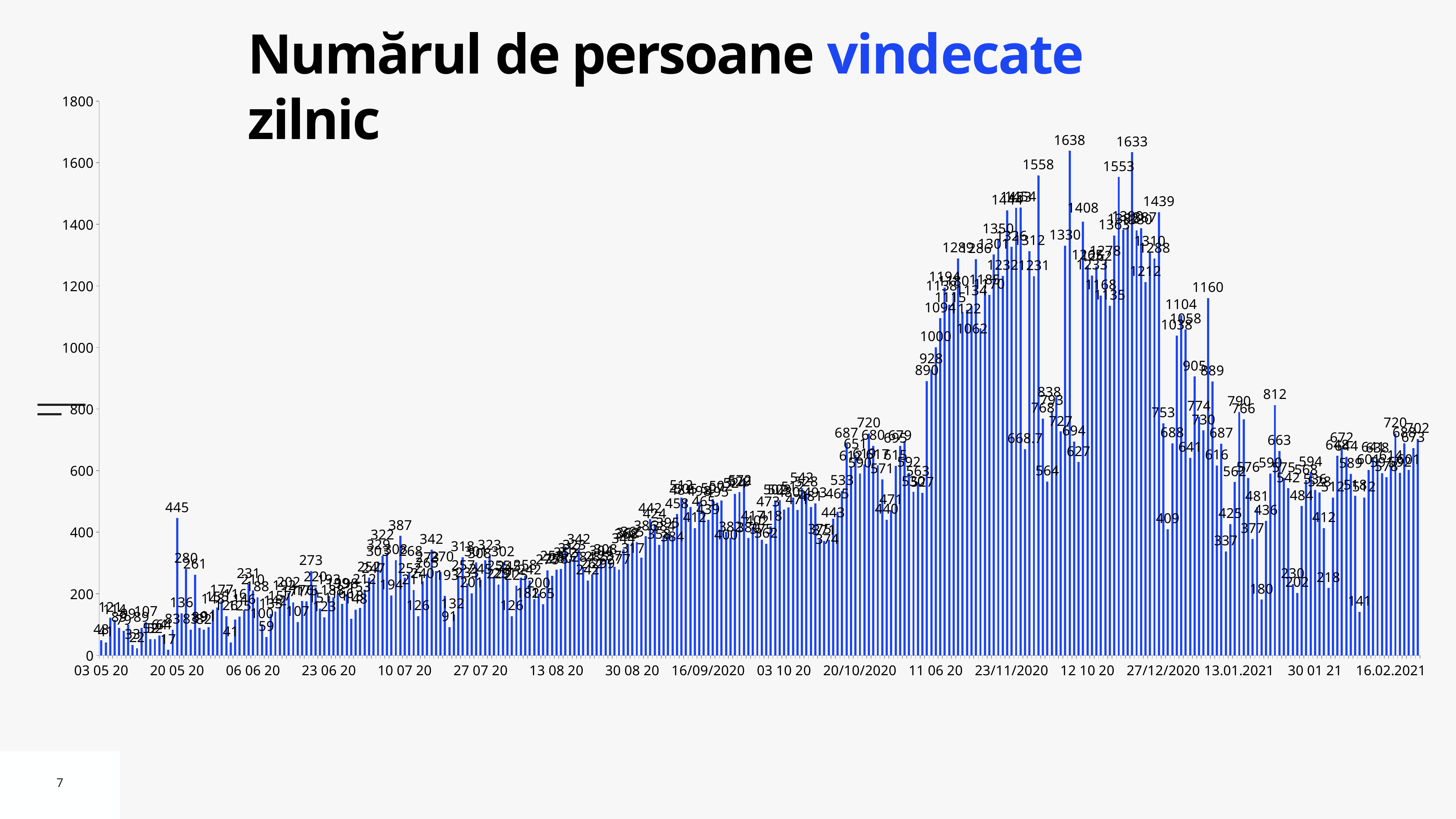
What is the maximum value shown on the vertical axis? 1800 Which is larger, the bar labeled 1638 or the bar labeled 1558? 1638 What kind of chart is shown on the slide? bar chart What is the difference between the two highest labeled values, 1638 and 1633? 5 Do the values generally rise or fall from 03 05 20 to 23/11/2020? rise What is the highest value labeled on the chart? 1638 Is the value for 23/11/2020 greater or less than 1000? greater Is the value for 06 06 20 greater or less than 400? less What is the second highest value labeled on the chart? 1633 What is the title of the chart? Numărul de persoane vindecate zilnic Is the value for 03 05 20 greater or less than 200? less